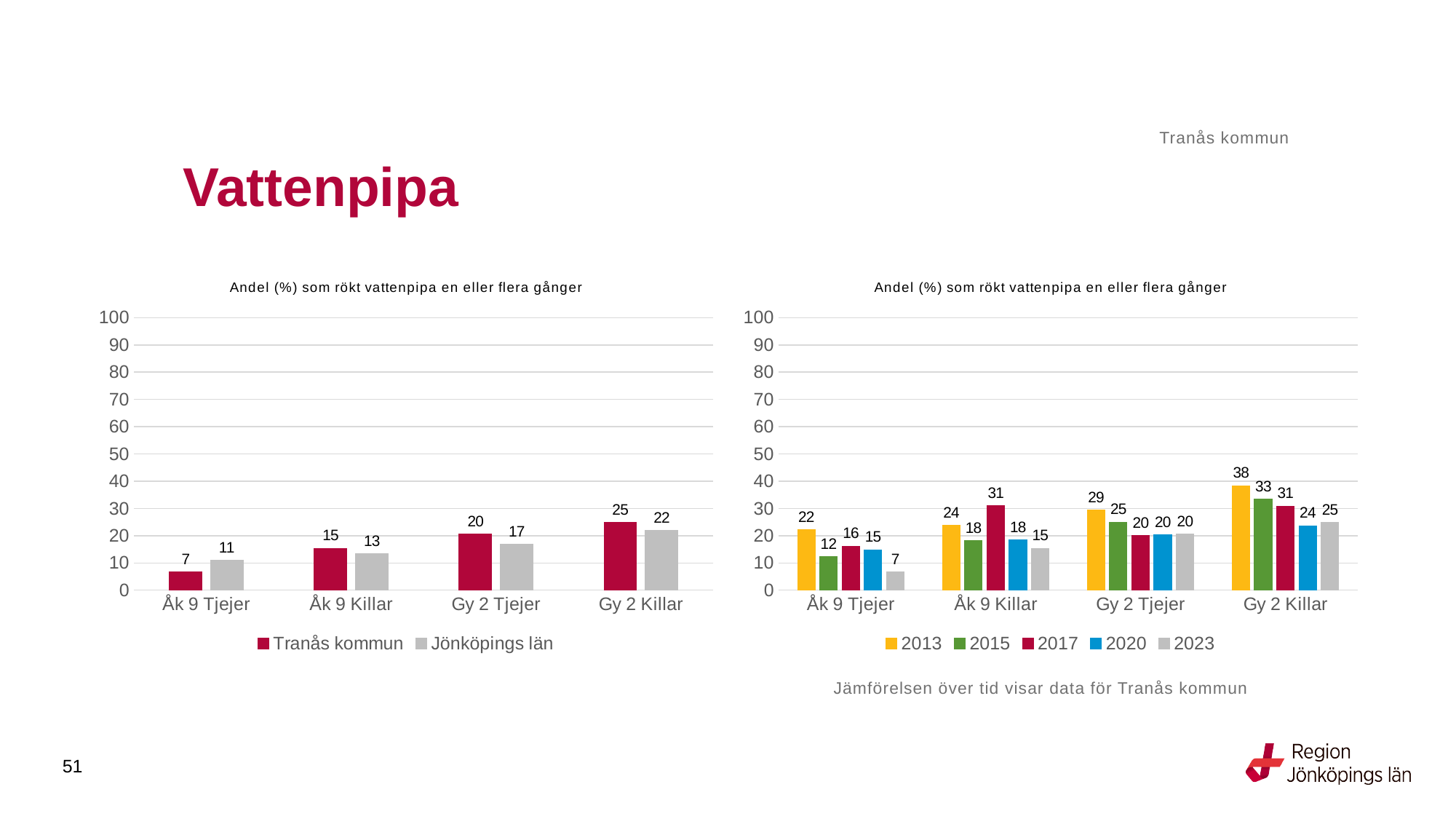
How many series does the legend of the left chart list? 2 In the right chart, what is the value for 2023 for Åk 9 Tjejer? 7 In the left chart, what is the value for Tranås kommun for Gy 2 Tjejer? 20 How many series does the legend of the right chart list? 5 In the left chart, what is the value for Jönköpings län for Åk 9 Tjejer? 11 In the left chart, which is larger for Åk 9 Killar: Tranås kommun or Jönköpings län? Tranås kommun In the left chart, what is the difference between Tranås kommun and Jönköpings län for Gy 2 Killar? 3 What type of chart is the right chart? Bar chart In the left chart, which category has the highest value for Tranås kommun? Gy 2 Killar In the right chart, what is the value for 2017 for Åk 9 Killar? 31 In the right chart, what is the difference between 2013 and 2023 for Gy 2 Killar? 13 In the right chart, which year has the highest value for Gy 2 Killar? 2013